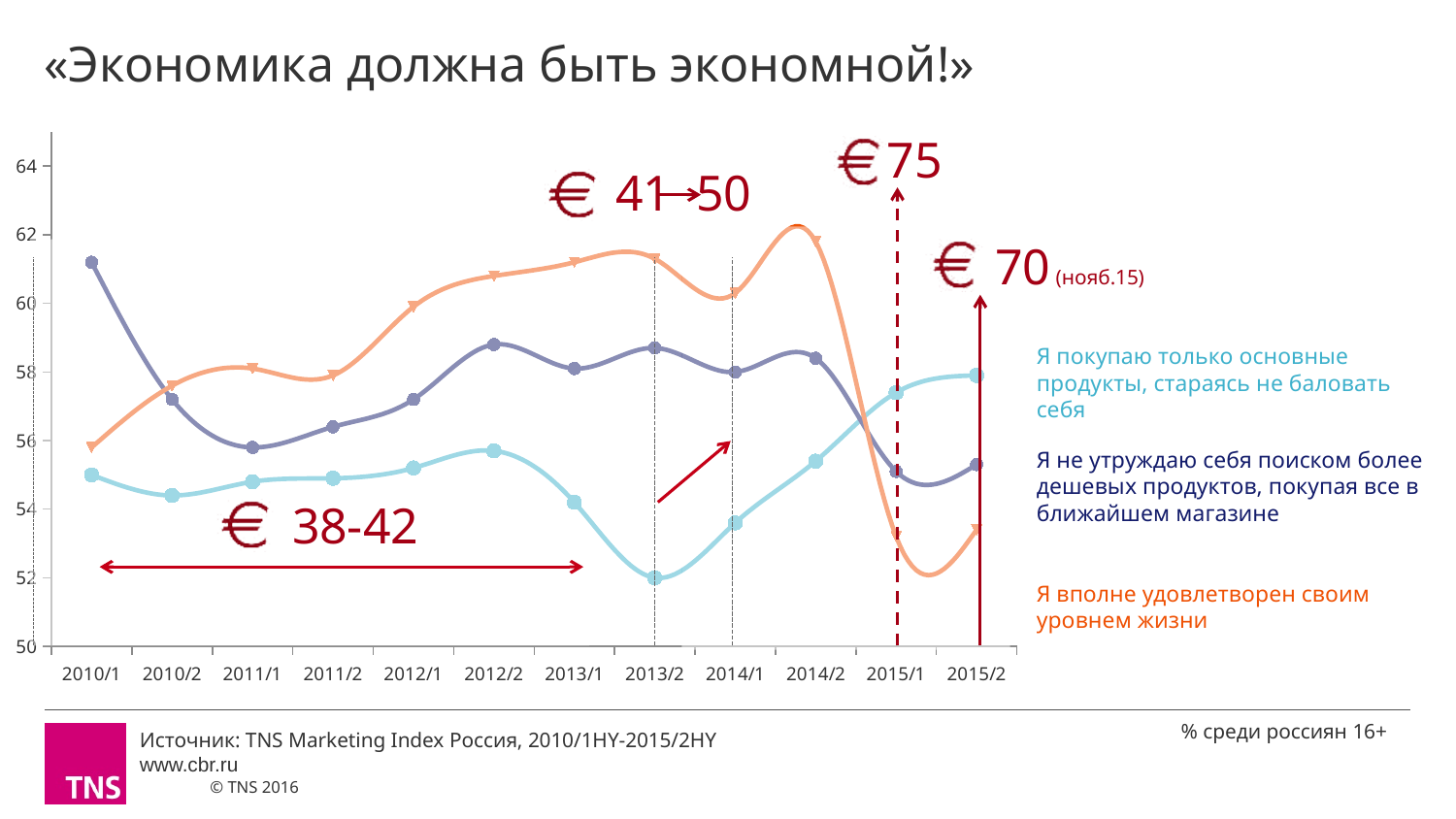
At 2010/1, which series has the higher value: the dark blue series or the orange series? the dark blue series Does the orange series rise or fall between 2014/2 and 2015/1? fall Is the value of the dark blue series (Я не утруждаю себя поиском более дешевых продуктов) at 2010/1 greater or less than 60? greater How many series are plotted on the chart? 3 In which period does the orange series (Я вполне удовлетворен своим уровнем жизни) reach its highest value? 2014/2 Is the value of the orange series (Я вполне удовлетворен своим уровнем жизни) at 2014/2 greater or less than 60? greater What kind of chart is shown on the slide? line chart Is the value of the light blue series (Я покупаю только основные продукты) at 2013/2 greater or less than 54? less How many time periods are shown on the x axis of the chart? 12 What is the title of the slide? «Экономика должна быть экономной!» In which period does the light blue series (Я покупаю только основные продукты) reach its lowest value? 2013/2